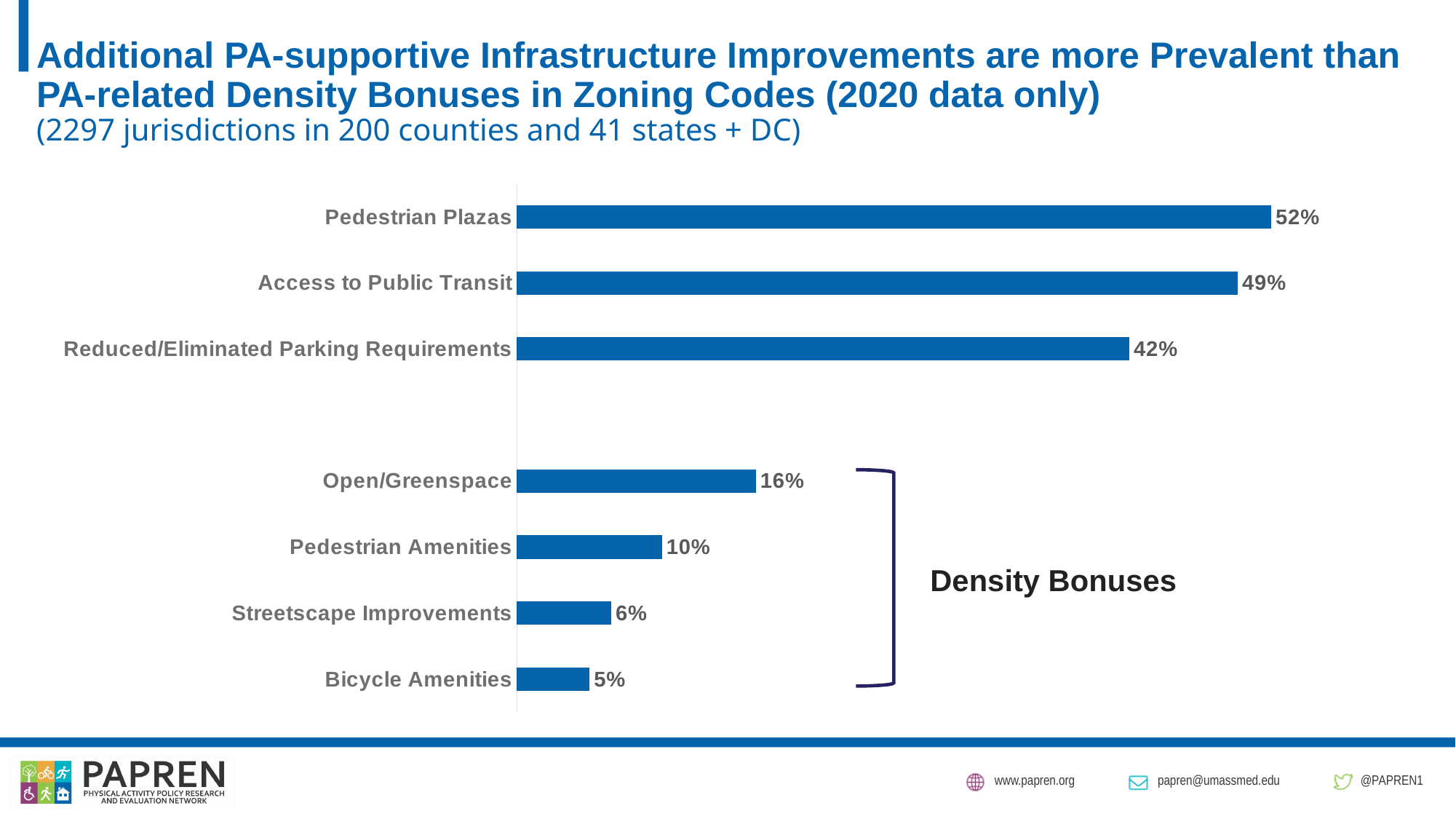
What is the value for Open/Greenspace? 16% Which category has the highest value? Pedestrian Plazas What is the value for Pedestrian Plazas? 52% How many categories are plotted in the chart? 7 What is the difference between the values for Open/Greenspace and Pedestrian Amenities? 6% What is the difference between the values for Pedestrian Plazas and Access to Public Transit? 3% What is the value for Bicycle Amenities? 5% What is the value for Access to Public Transit? 49% Which is larger, the value for Streetscape Improvements or the value for Bicycle Amenities? Streetscape Improvements Which category has the lowest value? Bicycle Amenities What kind of chart is shown on the slide? Bar chart What is the value for Reduced/Eliminated Parking Requirements? 42%